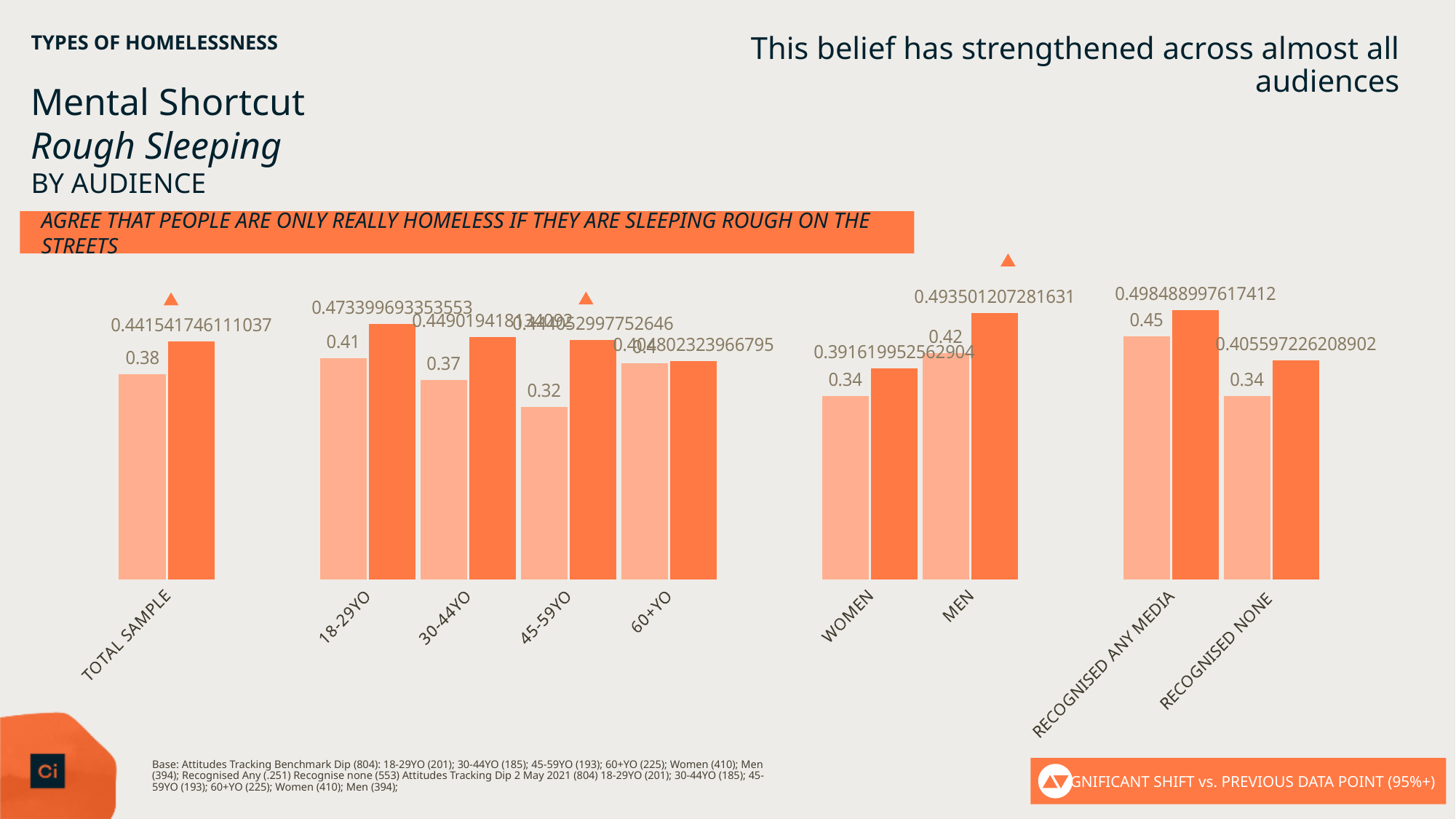
In the age group chart, what value is printed on the lighter orange bar for 18-29YO? 0.41 In the Total Sample chart, what value is printed on the lighter orange bar? 0.38 How many age group categories are shown in the age group chart? 4 In the gender chart, what value is printed on the darker orange bar for Men? 0.493501207281631 In the age group chart, what value is printed on the lighter orange bar for 45-59YO? 0.32 In the gender chart, which has the larger darker orange bar, Women or Men? Men In the recognised media chart, what value is printed on the darker orange bar for Recognised None? 0.405597226208902 In the age group chart, which age group has the lowest lighter orange bar? 45-59YO In the recognised media chart, what value is printed on the lighter orange bar for Recognised Any Media? 0.45 In the age group chart, what value is printed on the darker orange bar for 18-29YO? 0.473399693353553 In the Total Sample chart, what value is printed on the darker orange bar? 0.441541746111037 In the age group chart, what is the difference between the lighter orange bar values for 18-29YO and 45-59YO? 0.09